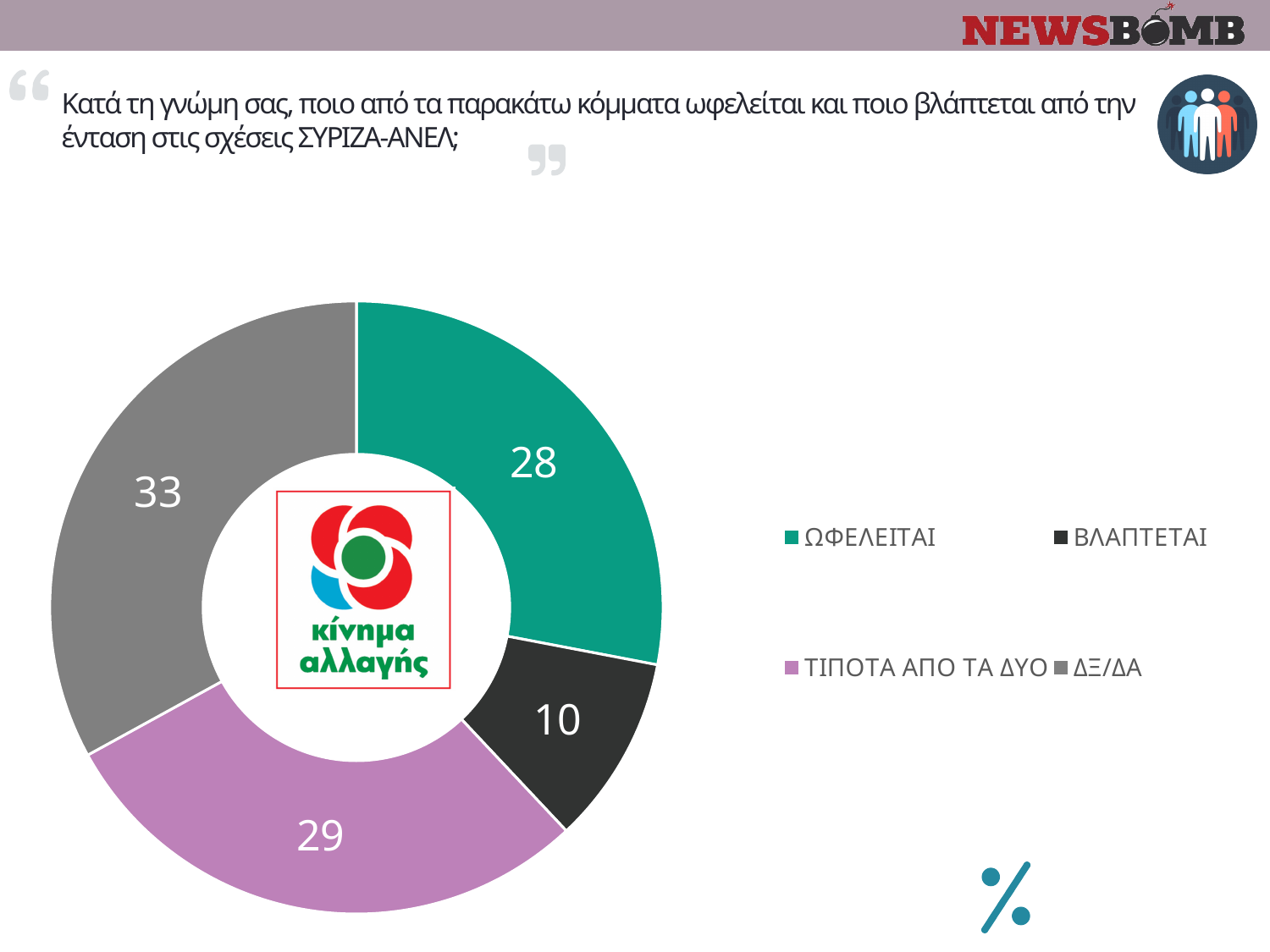
What is the difference between the values for ΔΞ/ΔΑ and ΒΛΑΠΤΕΤΑΙ? 23 What is the value for ΤΙΠΟΤΑ ΑΠΟ ΤΑ ΔΥΟ? 29 Which category has the lowest value? ΒΛΑΠΤΕΤΑΙ How many categories does the chart show? 4 What is the value for ΔΞ/ΔΑ? 33 Which category has the highest value? ΔΞ/ΔΑ What kind of chart is shown on the slide? doughnut (pie) chart What is the value for ΒΛΑΠΤΕΤΑΙ? 10 What share of the total does the ΔΞ/ΔΑ slice represent? 33% Which is larger, the value for ΤΙΠΟΤΑ ΑΠΟ ΤΑ ΔΥΟ or the value for ΩΦΕΛΕΙΤΑΙ? ΤΙΠΟΤΑ ΑΠΟ ΤΑ ΔΥΟ What colour is the ΩΦΕΛΕΙΤΑΙ slice? green What is the value for ΩΦΕΛΕΙΤΑΙ? 28